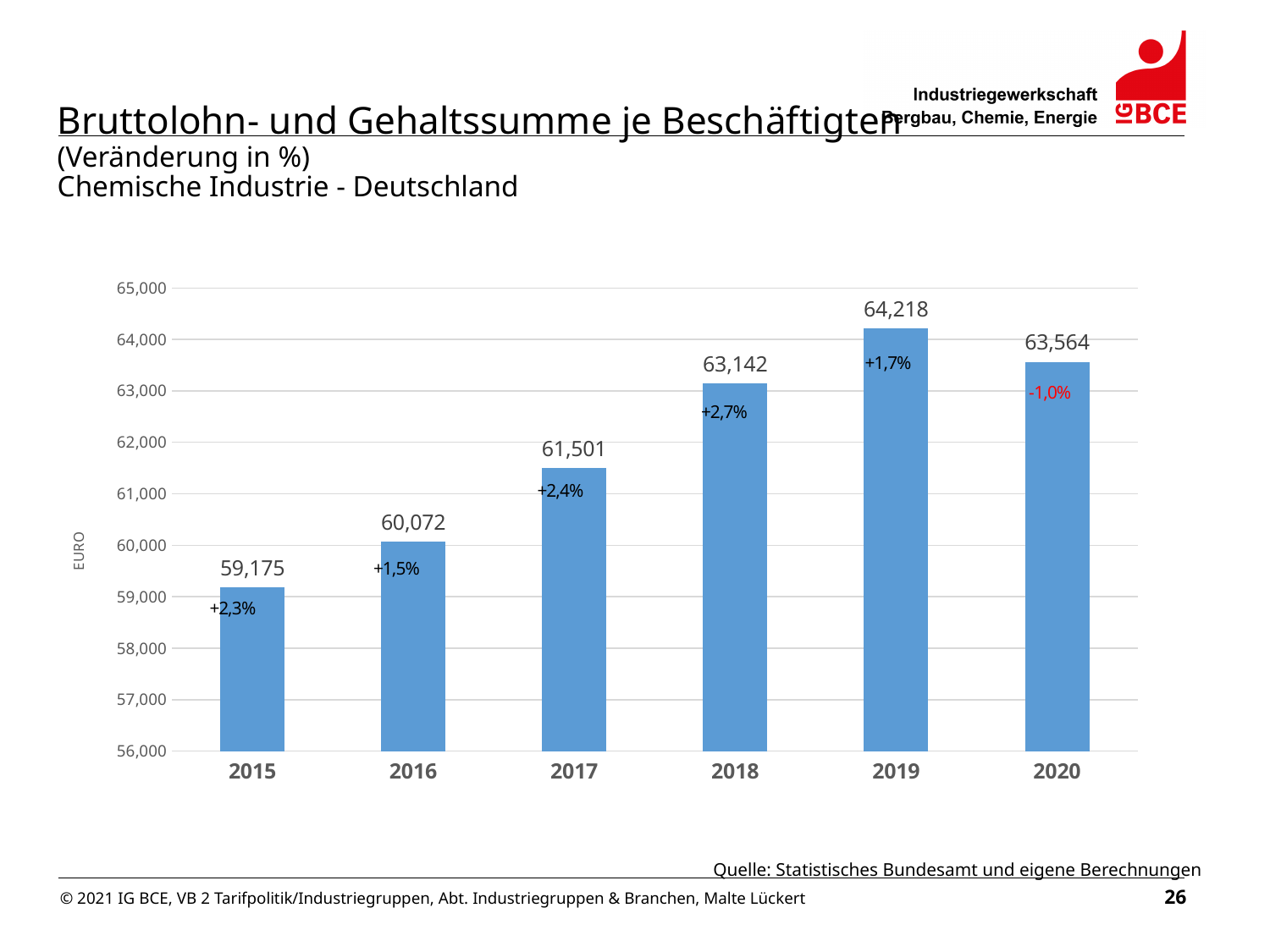
Which year has the highest value? 2019 Which is larger, the value for 2017 or the value for 2016? 2017 What is the value for 2015? 59,175 How many years are shown on the x axis? 6 What is the difference between the values for 2019 and 2020? 654 Which year has the lowest value? 2015 Is the value for 2017 greater or less than 62,000? less What kind of chart is shown? bar chart What percentage change is shown for 2020? -1,0% What is the value for 2018? 63,142 Do the values rise or fall from 2015 to 2019? rise What is the label on the vertical axis? EURO